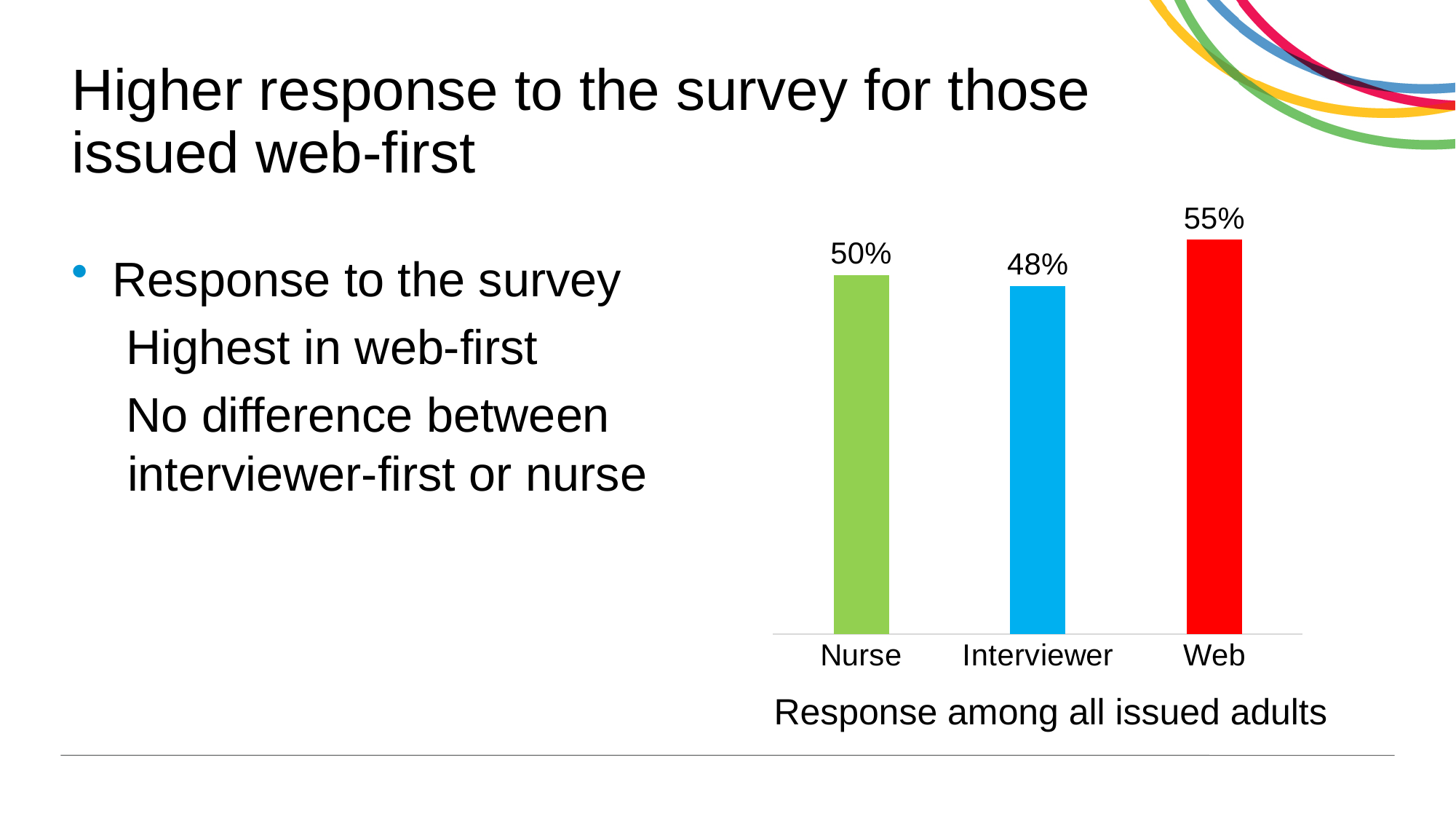
What is the response rate for Interviewer? 48% What is the difference between the response rates for Nurse and Interviewer? 2% What colour is the bar for Web? Red Which category has the lowest response rate? Interviewer What is the response rate for Nurse? 50% What is the caption below the chart? Response among all issued adults What kind of chart is shown on the slide? Bar chart What is the response rate for Web? 55% Which category has the highest response rate? Web What is the difference between the response rates for Web and Interviewer? 7% How many categories are shown in the chart? 3 Which has a higher response rate, Web or Nurse? Web